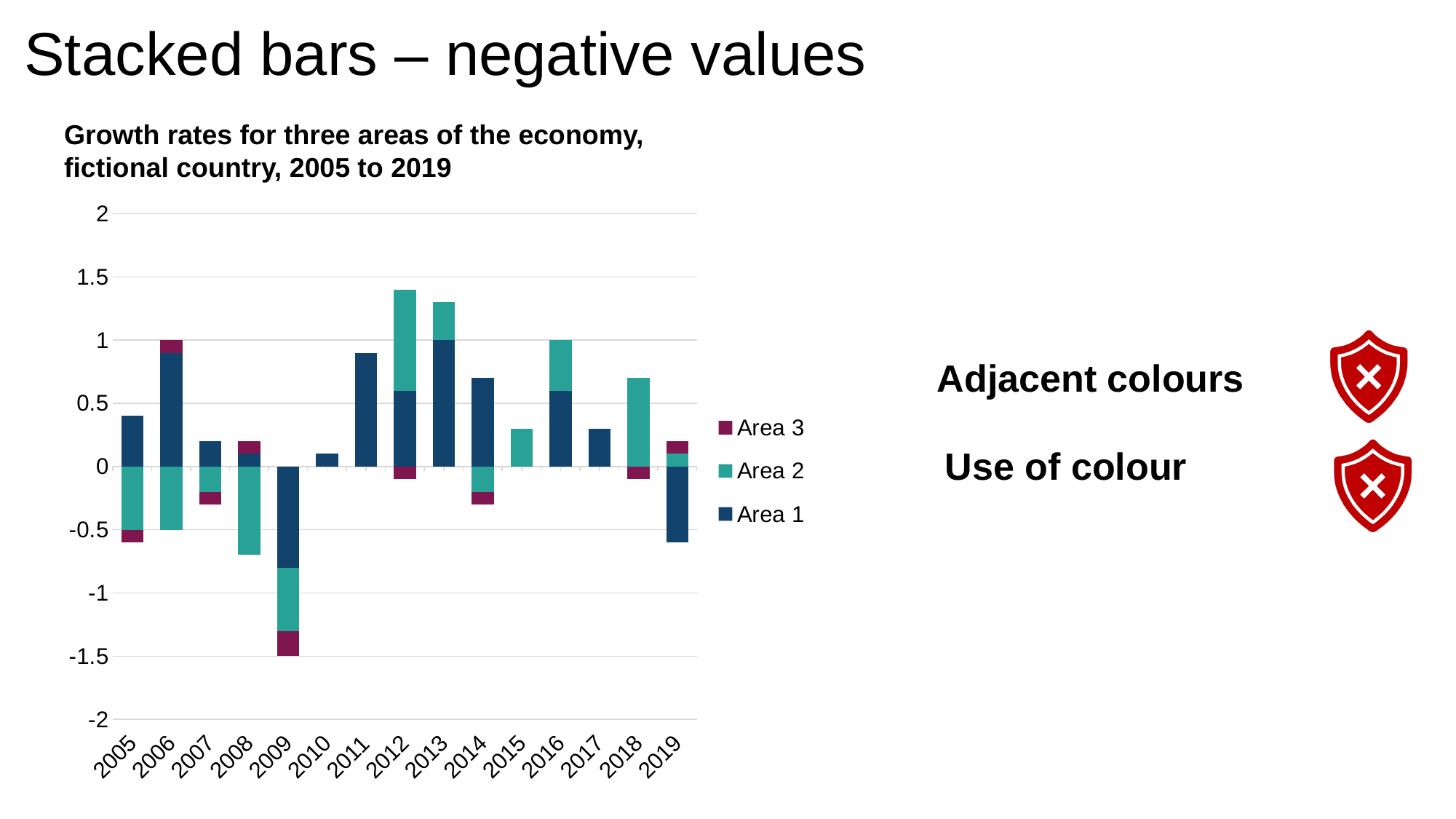
Is the value for Area 1 in 2011 greater or less than 0.5? greater Is the value for Area 2 in 2015 greater or less than 0.5? less Is the top of the stacked bar for 2012 greater or less than 1? greater Which is larger, the Area 1 value in 2013 or the Area 1 value in 2012? 2013 How many years are shown along the x axis? 15 What is the title of the chart? Growth rates for three areas of the economy, fictional country, 2005 to 2019 What is the value for Area 1 in 2013? 1 How many series does the legend list? 3 What kind of chart is shown on the slide? bar chart Which year has the lowest (most negative) stacked bar? 2009 Which series is shown in dark blue? Area 1